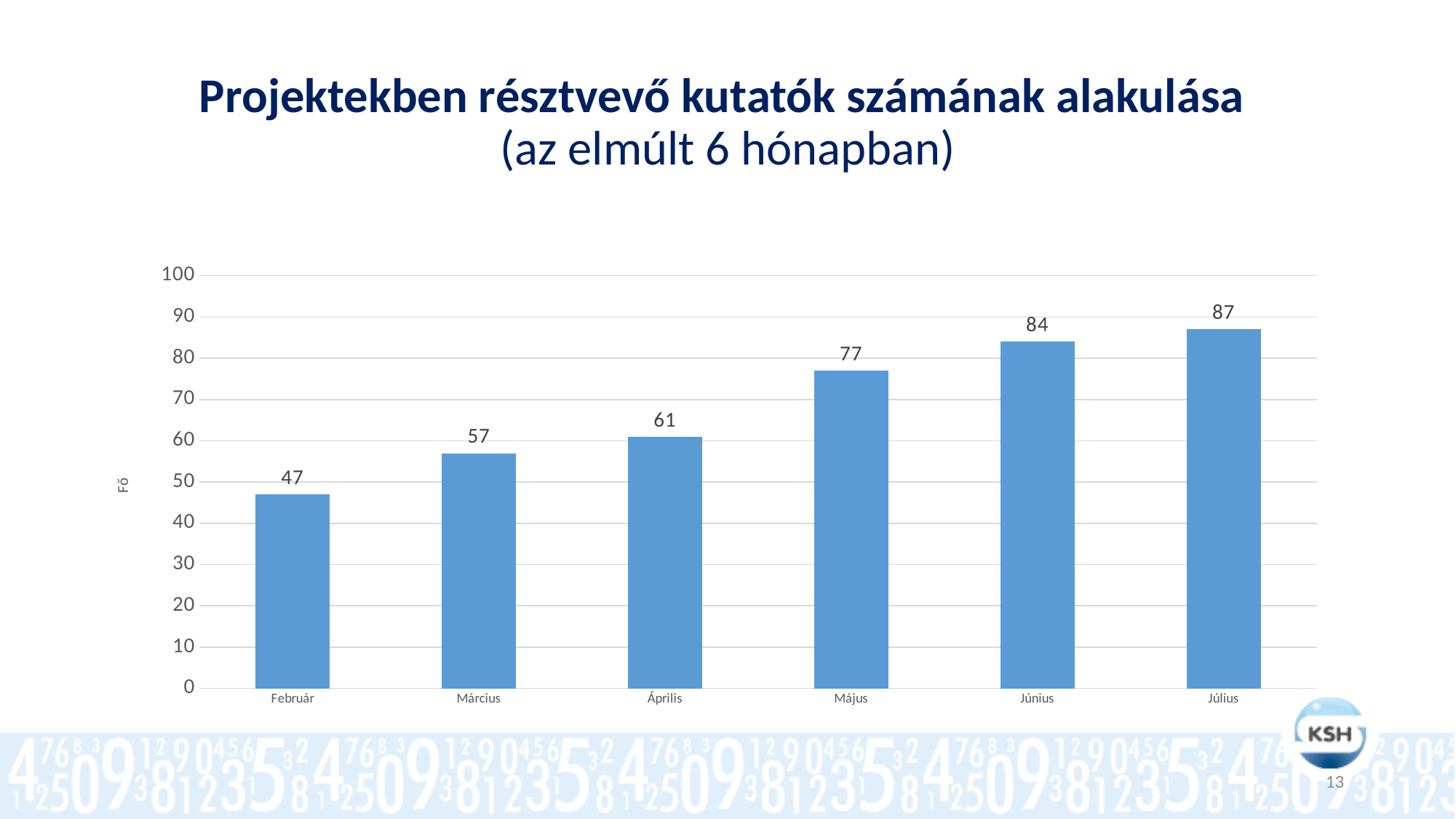
Do the values rise or fall from Február to Július? rise Which month has the lowest value? Február What is the value for Június? 84 What kind of chart is shown on the slide? bar chart How many months are shown on the x axis? 6 What is the value for Május? 77 What is the difference between the values for Július and Február? 40 What is the difference between the values for Április and Március? 4 Is the value for Június greater or less than 80? greater What is the value for Február? 47 Which is larger, the value for Május or the value for Április? Május Which month has the highest value? Július